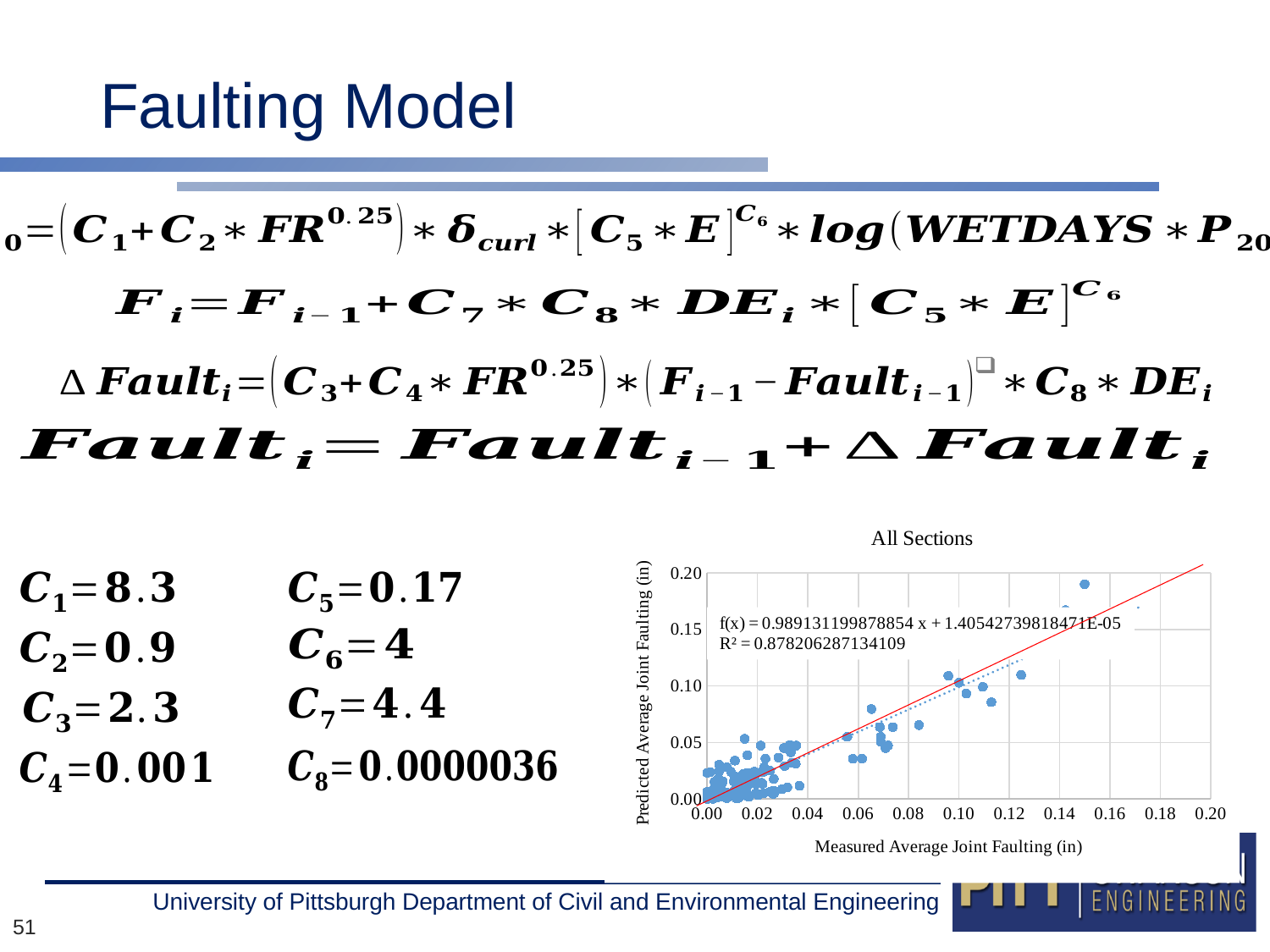
Is the predicted value of the highest plotted point greater or less than 0.15? greater What is the intercept of the fitted line equation printed on the chart? 1.40542739818471E-05 What kind of chart is shown on the slide? scatter chart What is the maximum value shown on the x axis of the chart? 0.20 What is the slope of the fitted line equation printed on the chart? 0.989131199878854 What is the title of the chart? All Sections What is the label of the x axis of the chart? Measured Average Joint Faulting (in) What is the maximum value shown on the y axis of the chart? 0.20 Is the R² value printed on the chart greater or less than 0.90? less Do the predicted values generally rise or fall as measured faulting increases along the x axis? rise What R² value is printed on the chart? R² = 0.878206287134109